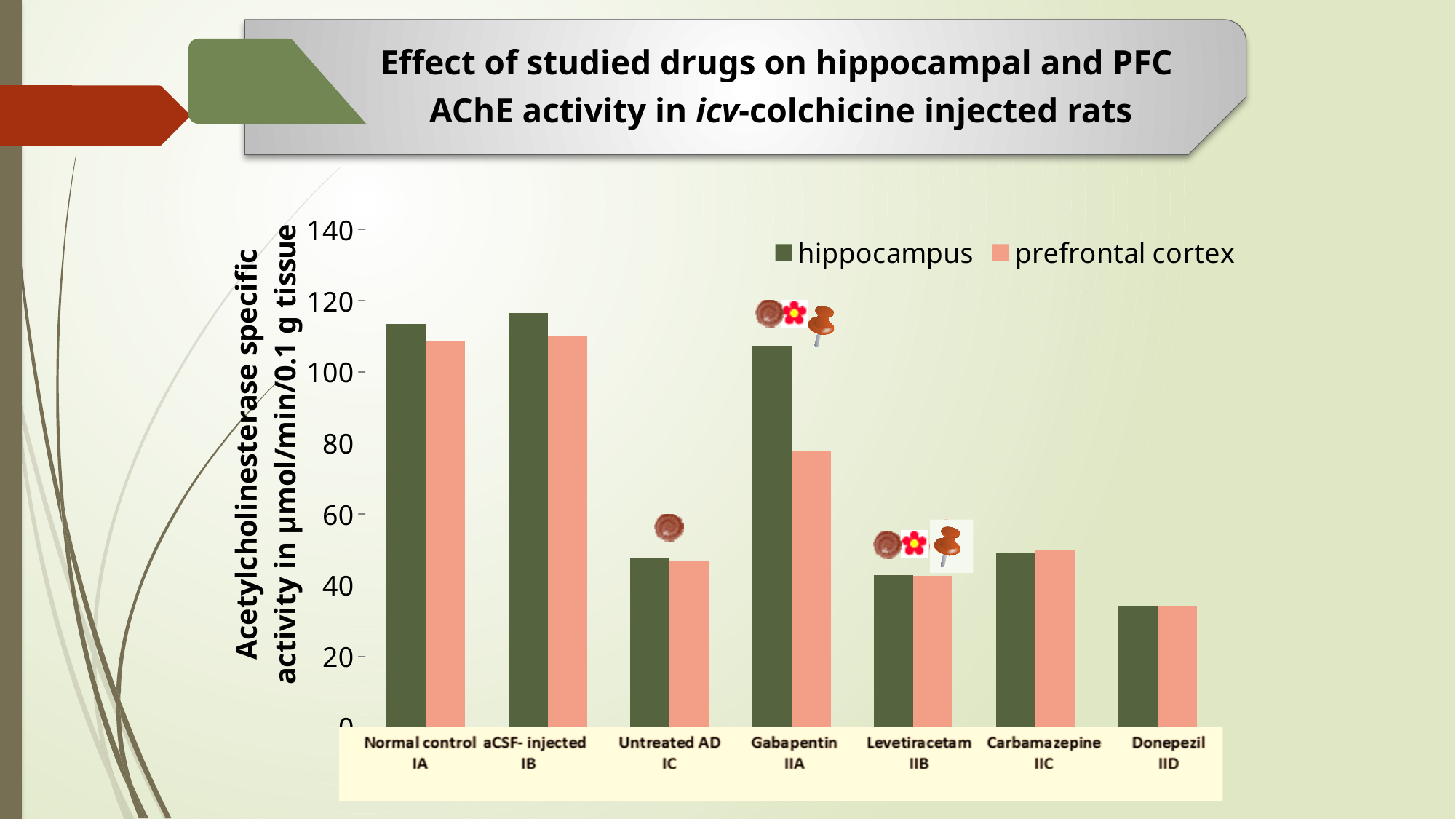
Which group has the lowest hippocampus AChE activity? Donepezil IID Is the hippocampus value for Untreated AD IC greater or less than 60? less Which group has the lowest prefrontal cortex AChE activity? Donepezil IID Which series is shown in dark green in the legend? hippocampus How many series does the legend list? 2 Is the hippocampus value for Gabapentin IIA greater or less than 100? greater Which group has the highest hippocampus AChE activity? aCSF- injected IB For Gabapentin IIA, which is larger: the hippocampus value or the prefrontal cortex value? hippocampus What kind of chart is shown on the slide? bar chart How many treatment groups are shown along the x axis? 7 Is the hippocampus value for Donepezil IID greater or less than 40? less